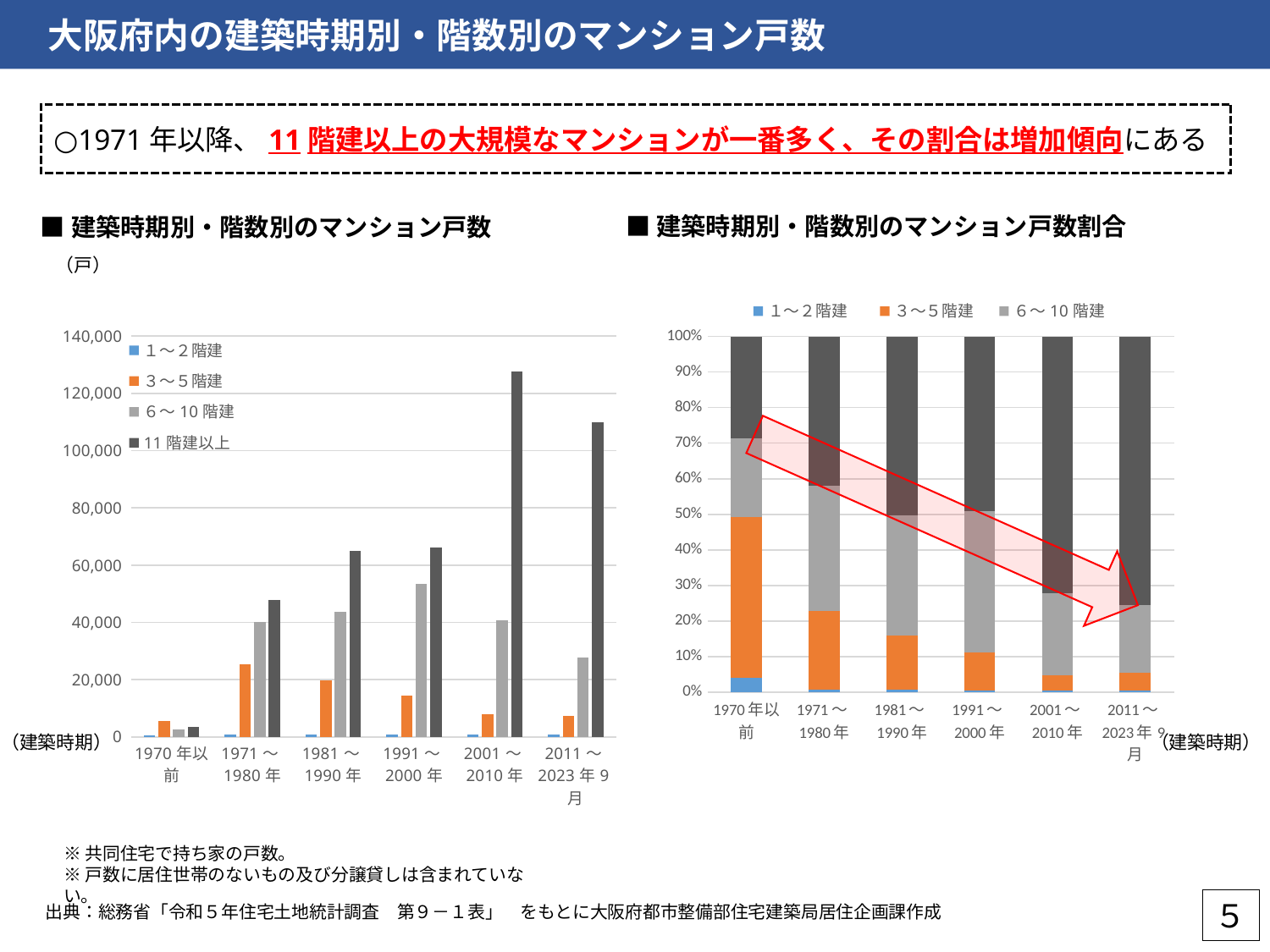
What kind of chart is the left chart titled 建築時期別・階数別のマンション戸数? bar chart In the left chart (建築時期別・階数別のマンション戸数), how many building-period categories are shown on the x axis? 6 In the left chart (建築時期別・階数別のマンション戸数), is the value for 11階建以上 in 2001～2010年 greater or less than 120,000? greater In the right chart (建築時期別・階数別のマンション戸数割合), is the share of 3～5階建 in 1970年以前 greater or less than 40%? greater In the left chart (建築時期別・階数別のマンション戸数), which building period has the highest bar for 11階建以上? 2001～2010年 What kind of chart is the right chart titled 建築時期別・階数別のマンション戸数割合? stacked bar chart In the right chart (建築時期別・階数別のマンション戸数割合), does the share of 3～5階建 rise or fall from 1970年以前 to 2011～2023年9月? fall In the left chart (建築時期別・階数別のマンション戸数), is the value for 6～10階建 in 1991～2000年 greater or less than 40,000? greater In the left chart (建築時期別・階数別のマンション戸数), what colour represents the 3～5階建 series? orange In the left chart (建築時期別・階数別のマンション戸数), how many series does the legend list? 4 In the left chart (建築時期別・階数別のマンション戸数), which is larger for 6～10階建: 1991～2000年 or 2001～2010年? 1991～2000年